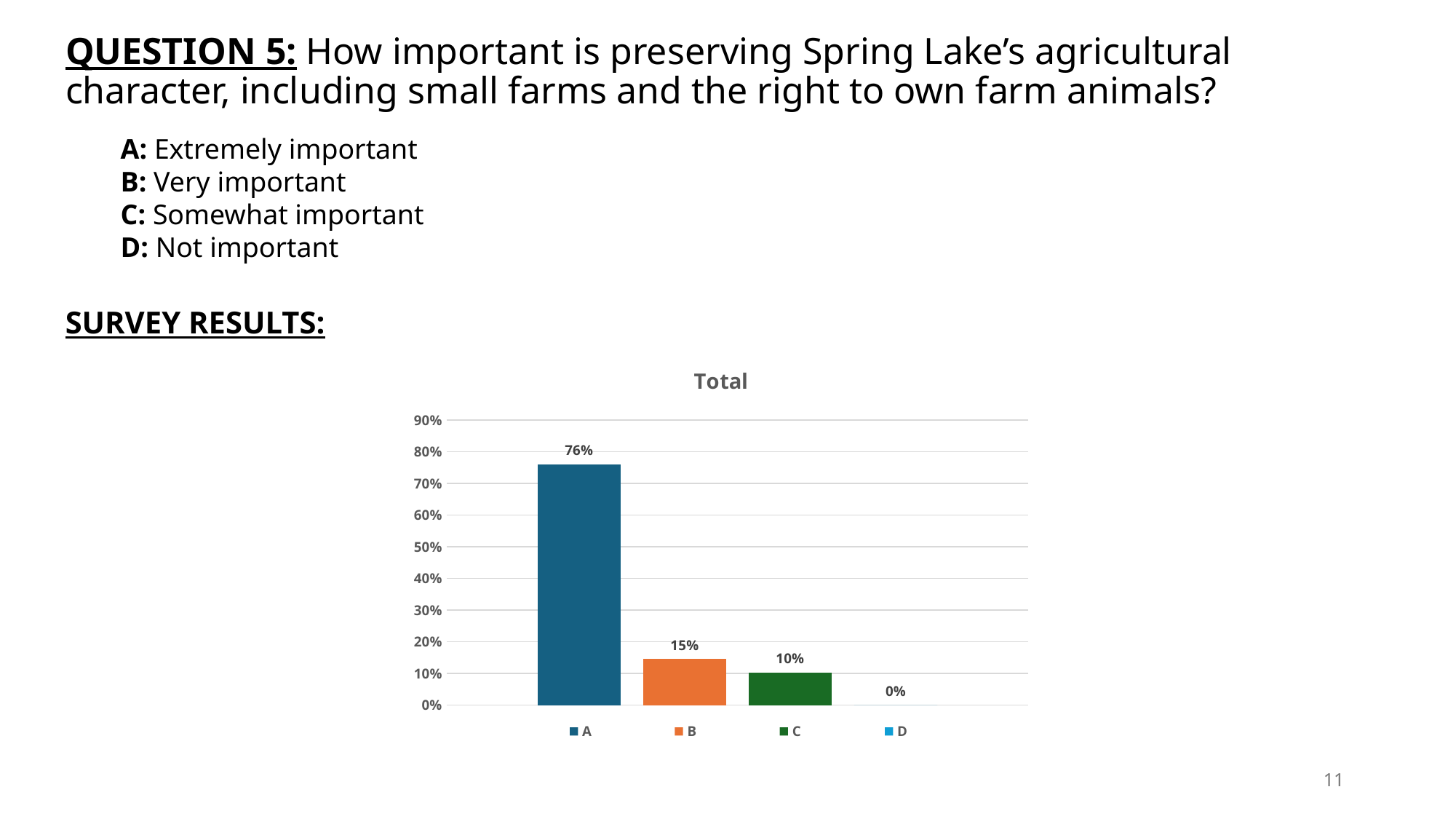
Which category has the highest value? A Which category has the lowest value? D What is the difference between the values for A and B? 61% What is the value for D in the chart? 0% Which is larger, the value for B or the value for C? B How many categories are shown in the chart? 4 What is the title of the chart? Total What kind of chart is shown on the slide? Bar chart What is the difference between the values for B and C? 5% What is the value for A in the chart? 76% What is the value for C in the chart? 10% What is the value for B in the chart? 15%